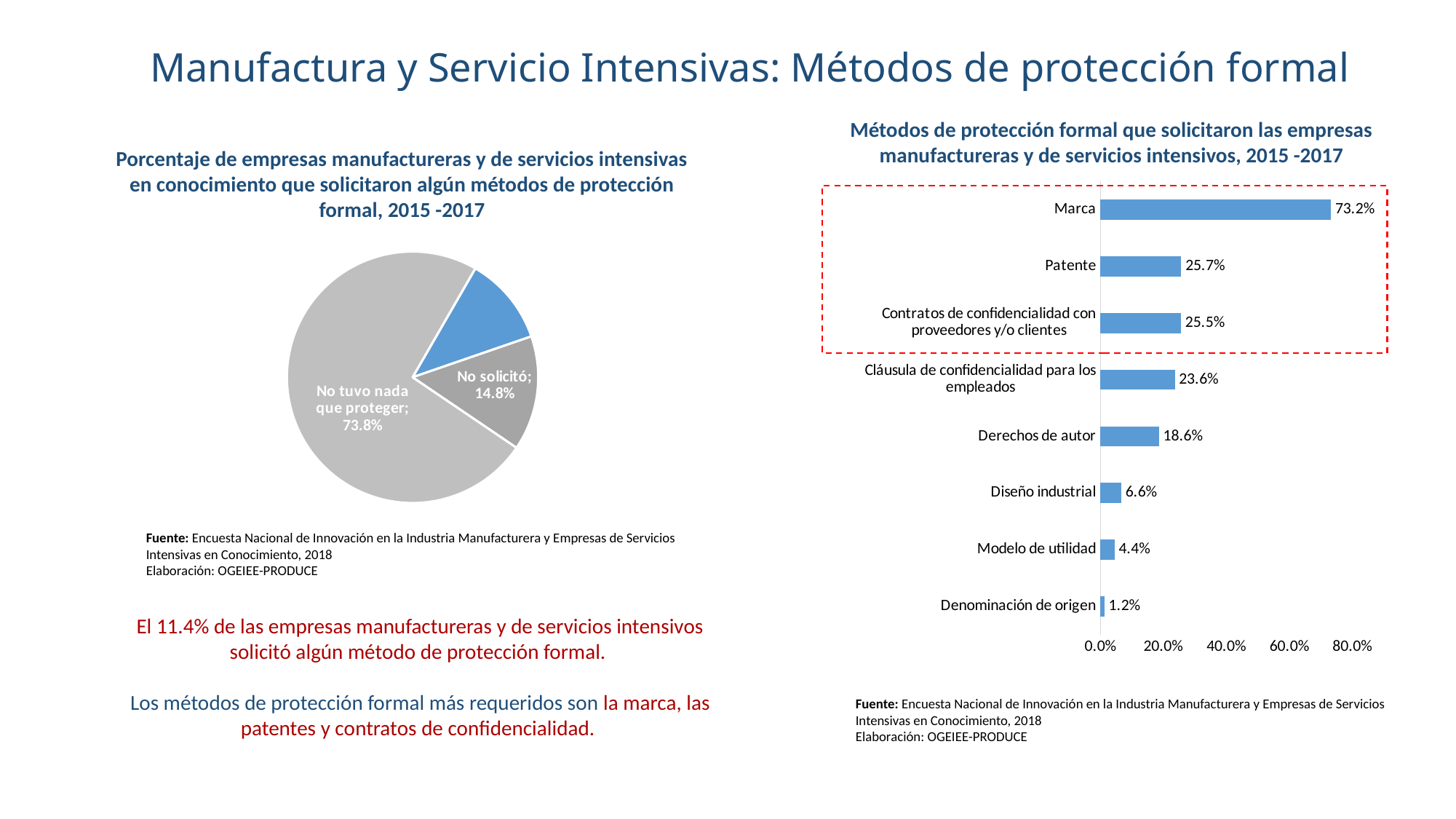
In the bar chart on the right, which category has the lowest value? Denominación de origen What kind of chart is the chart on the right of the slide? Bar chart In the bar chart on the right, what is the difference between the values for Marca and Patente? 47.5% In the bar chart on the right, which category has the highest value? Marca What kind of chart is the chart on the left of the slide? Pie chart In the bar chart on the right, what is the value for Derechos de autor? 18.6% In the pie chart on the left, what is the share for 'No tuvo nada que proteger'? 73.8% How many categories are shown in the bar chart on the right? 8 In the bar chart on the right, what is the value for Denominación de origen? 1.2% In the pie chart on the left, what is the share for 'No solicitó'? 14.8% In the bar chart on the right, which is larger: Diseño industrial or Modelo de utilidad? Diseño industrial In the bar chart on the right, what is the value for Marca? 73.2%